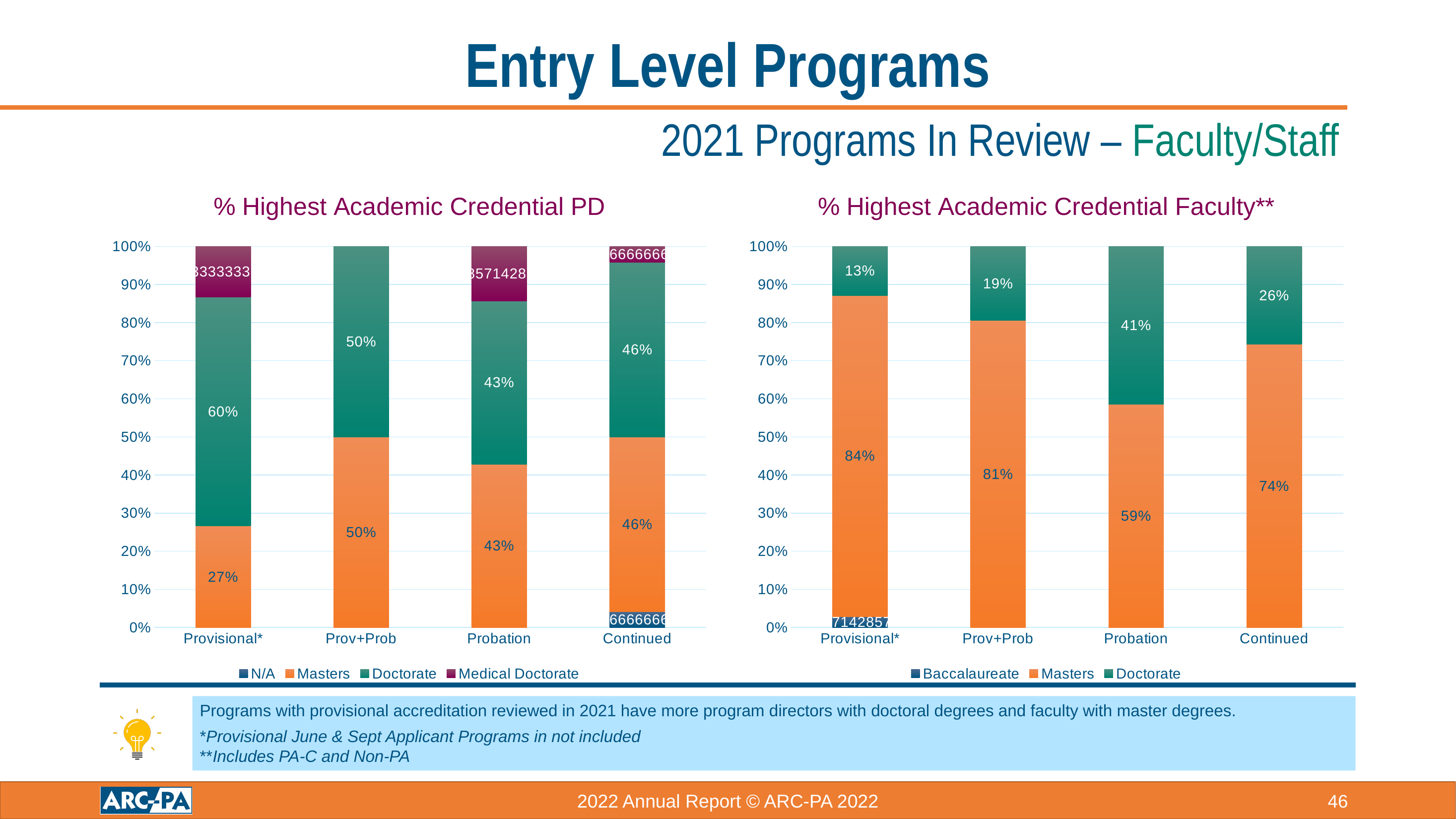
What kind of chart is the '% Highest Academic Credential Faculty**' chart? stacked bar chart In the '% Highest Academic Credential PD' chart, is the Doctorate value for Prov+Prob larger or smaller than the Doctorate value for Probation? larger In the '% Highest Academic Credential Faculty**' chart, what is the difference between the Masters values for Prov+Prob and Continued? 7% In the '% Highest Academic Credential Faculty**' chart, what is the Masters value for Provisional*? 84% In the '% Highest Academic Credential Faculty**' chart, which category has the lowest Doctorate value? Provisional* In the '% Highest Academic Credential Faculty**' chart, which category has the highest Masters value? Provisional* In the '% Highest Academic Credential Faculty**' chart, what is the Doctorate value for Probation? 41% In the '% Highest Academic Credential PD' chart, what is the Doctorate value for Provisional*? 60% In the '% Highest Academic Credential PD' chart, what is the Masters value for Provisional*? 27% How many series does the legend of the '% Highest Academic Credential PD' chart list? 4 In the '% Highest Academic Credential PD' chart, what is the Doctorate value for Probation? 43% In the '% Highest Academic Credential PD' chart, what is the Masters value for Continued? 46%